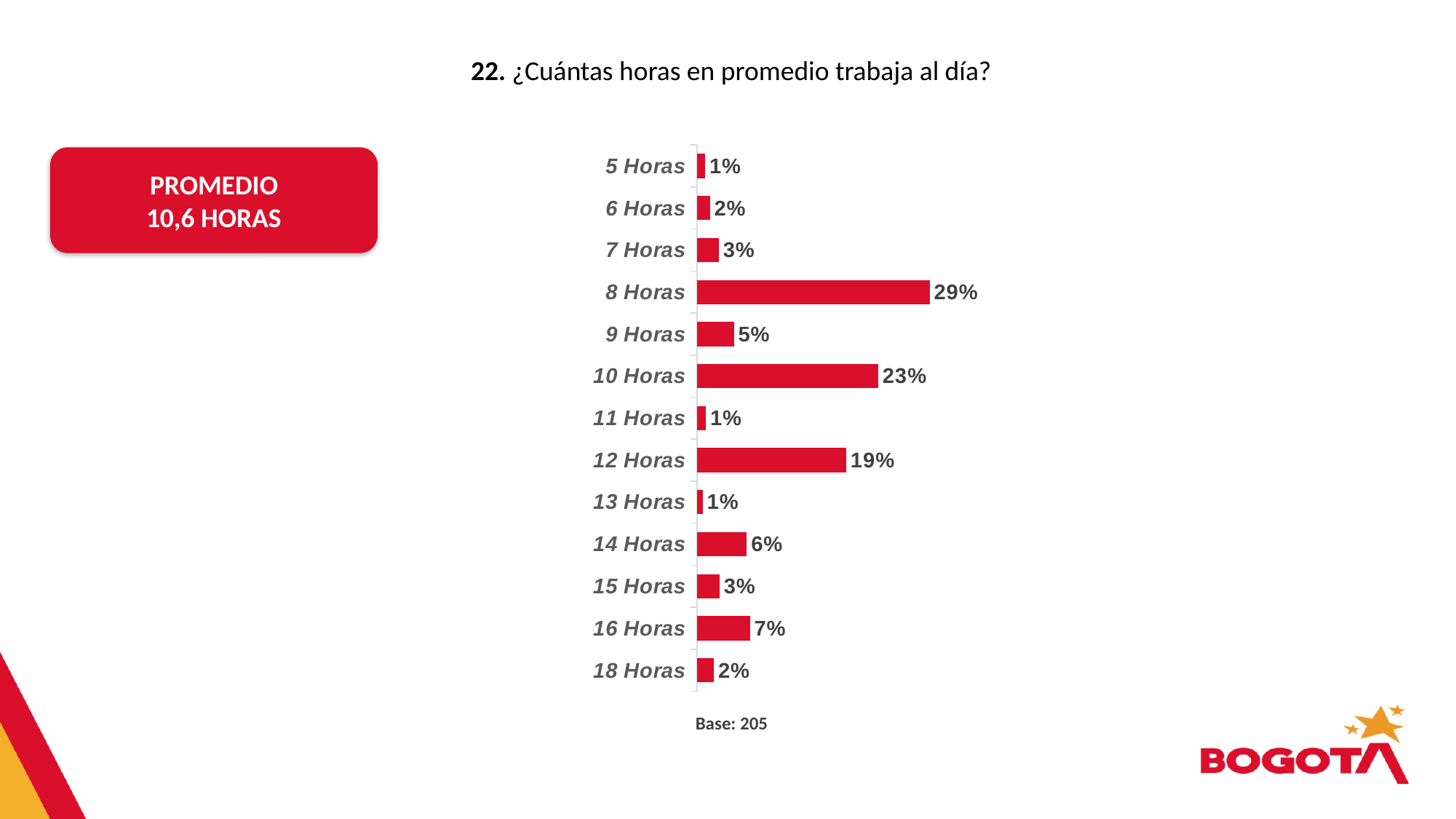
What kind of chart is shown on the slide? Bar chart What is the difference between the values for 12 Horas and 14 Horas? 13% Which category has the highest value? 8 Horas How many categories are shown in the chart? 13 What is the difference between the values for 8 Horas and 10 Horas? 6% What is the value shown for 12 Horas? 19% What is the base (number of respondents) shown below the chart? 205 Which is larger, the value for 10 Horas or the value for 12 Horas? 10 Horas What is the value shown for 10 Horas? 23% Which is larger, the value for 9 Horas or the value for 14 Horas? 14 Horas What percentage of respondents work 8 Horas per day? 29% What is the value shown for 16 Horas? 7%